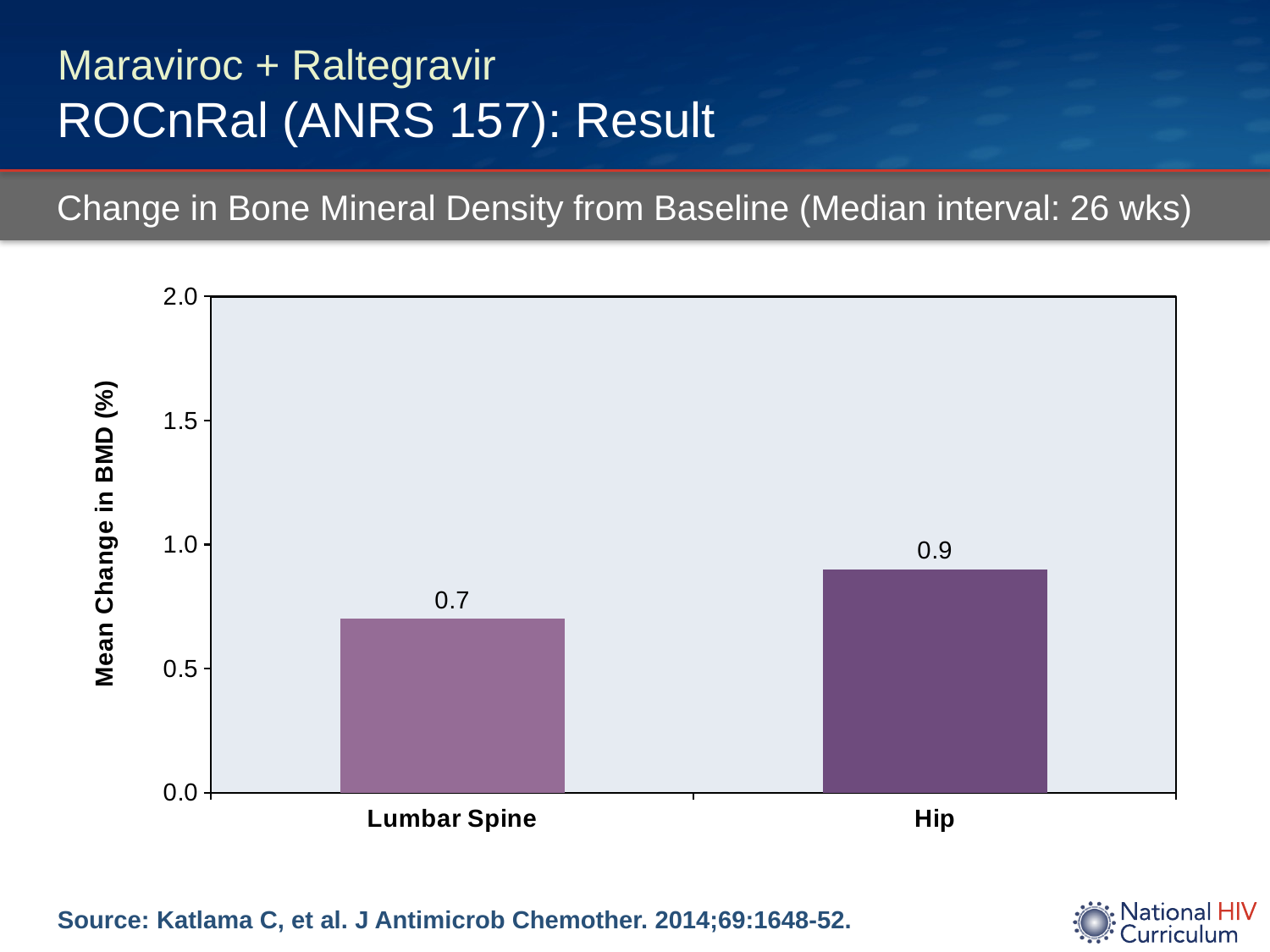
What is the label of the y axis of the chart? Mean Change in BMD (%) How many categories are shown on the x axis of the chart? 2 What kind of chart is shown on the slide? Bar chart Is the value for Hip greater or less than 1.0? less What is the maximum value shown on the y axis of the chart? 2.0 Is the value for Lumbar Spine greater or less than 0.5? greater What is the mean change in BMD for Hip? 0.9 Is the mean change in BMD larger for Hip or for Lumbar Spine? Hip What is the difference between the mean change in BMD for Hip and for Lumbar Spine? 0.2 Which category has the higher mean change in BMD? Hip What is the mean change in BMD for Lumbar Spine? 0.7 Which category has the lower mean change in BMD? Lumbar Spine